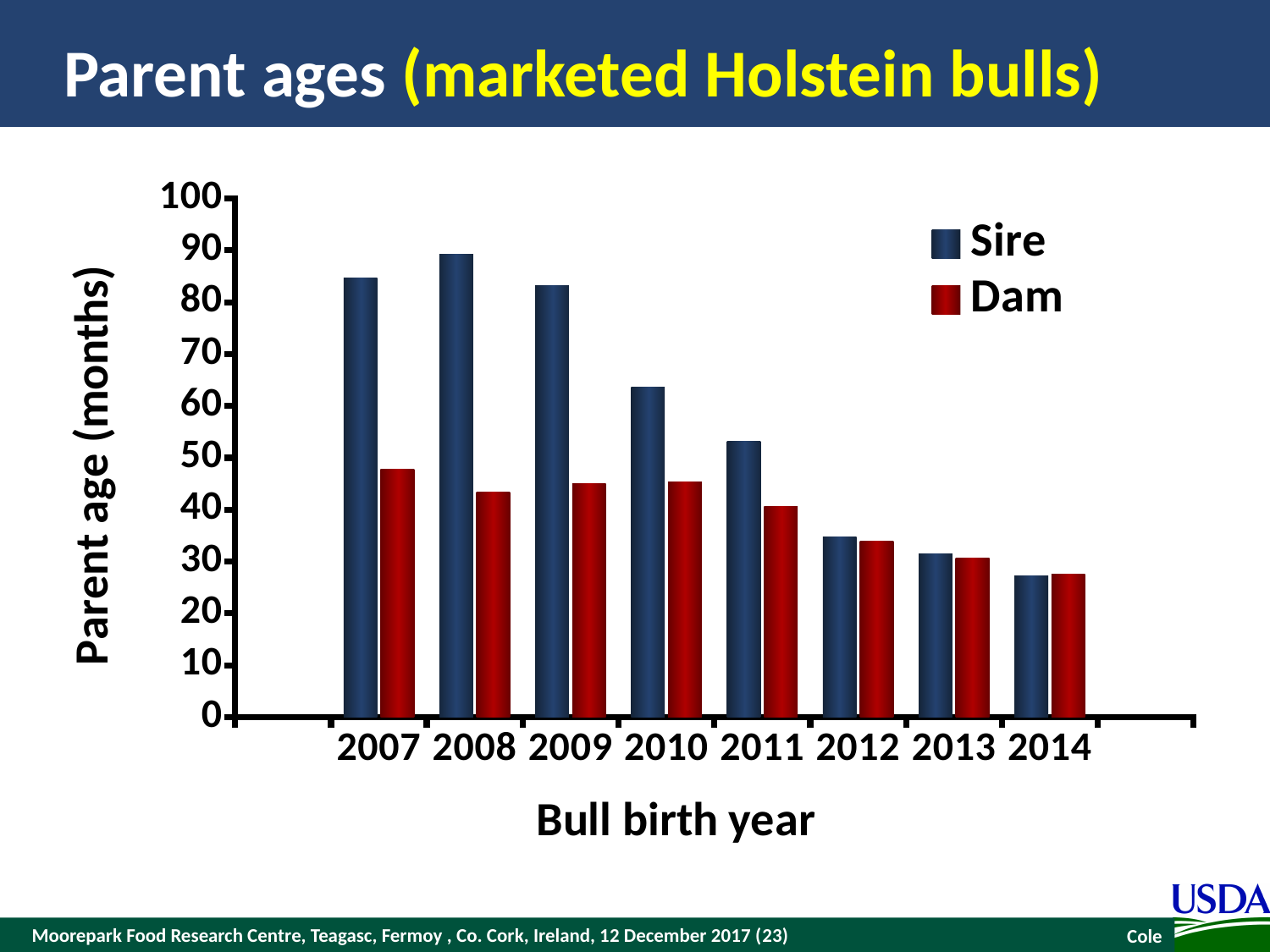
What kind of chart is shown on the slide? Bar chart Is the Sire age for 2008 greater or less than 80 months? greater Does the Sire age rise or fall from 2007 to 2014? Fall Is the Sire age for 2014 greater or less than 30 months? less Is the Sire age for 2012 greater or less than 40 months? less Which bull birth year has the highest Dam age? 2007 Which bull birth year has the lowest Sire age? 2014 How many bull birth years are shown on the x axis? 8 How many series does the legend list? 2 For bull birth year 2007, which is larger, the Sire age or the Dam age? Sire Which bull birth year has the highest Sire age? 2008